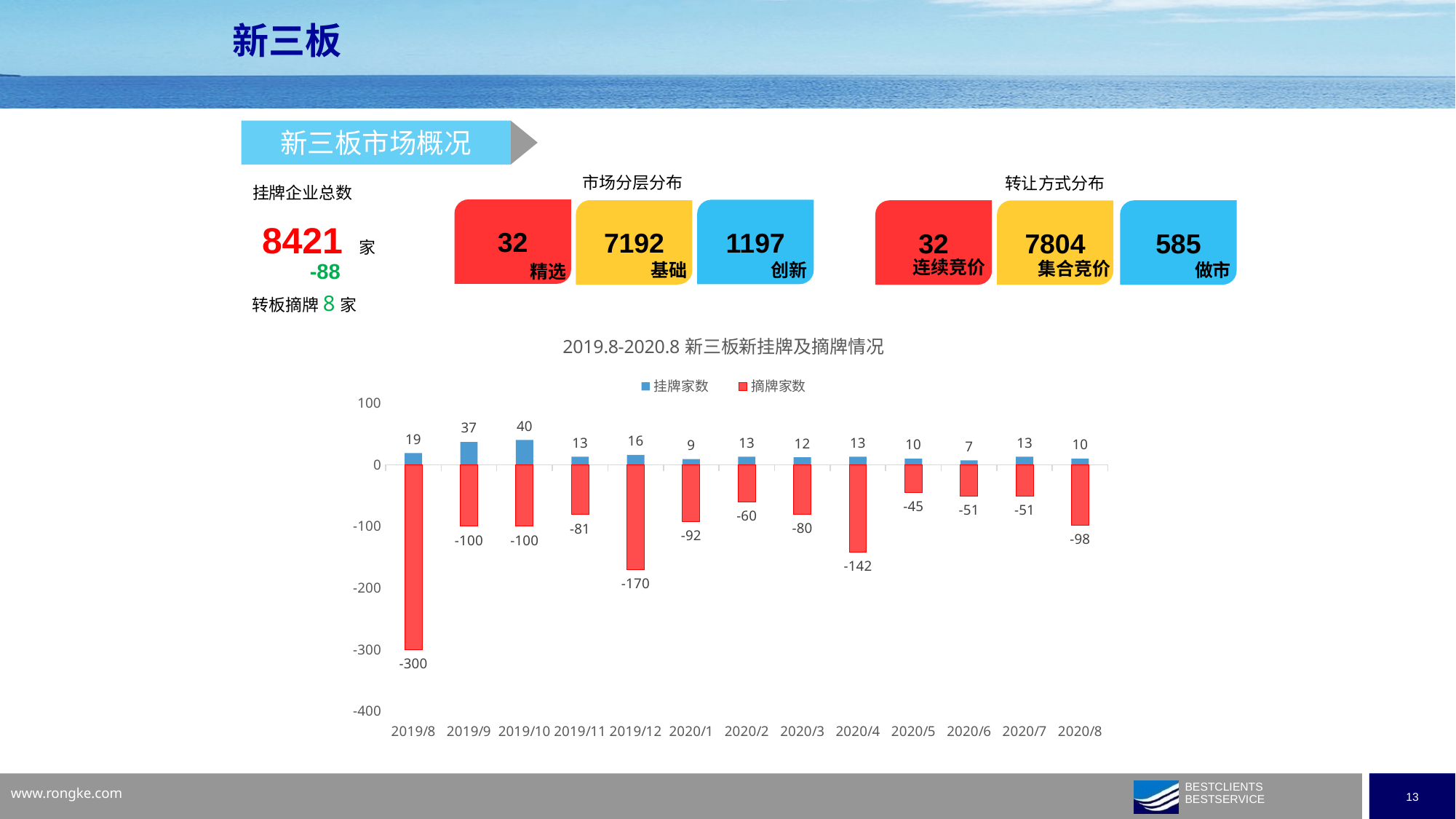
What is the difference between the 挂牌家数 values for 2019/9 and 2019/8? 18 Which month has the highest 挂牌家数 value? 2019/10 What type of chart is shown on the slide? bar chart What is the title of the chart? 2019.8-2020.8 新三板新挂牌及摘牌情况 Which month has the lowest 挂牌家数 value? 2020/6 What is the 挂牌家数 value for 2019/10? 40 How many months are shown on the x axis of the chart? 13 What is the 摘牌家数 value for 2019/12? -170 What is the 摘牌家数 value for 2020/4? -142 Which month has the lowest 摘牌家数 value (the largest number of delistings)? 2019/8 Which is larger in absolute terms, the 摘牌家数 for 2020/1 or for 2020/2? 2020/1 How many series does the chart legend list? 2